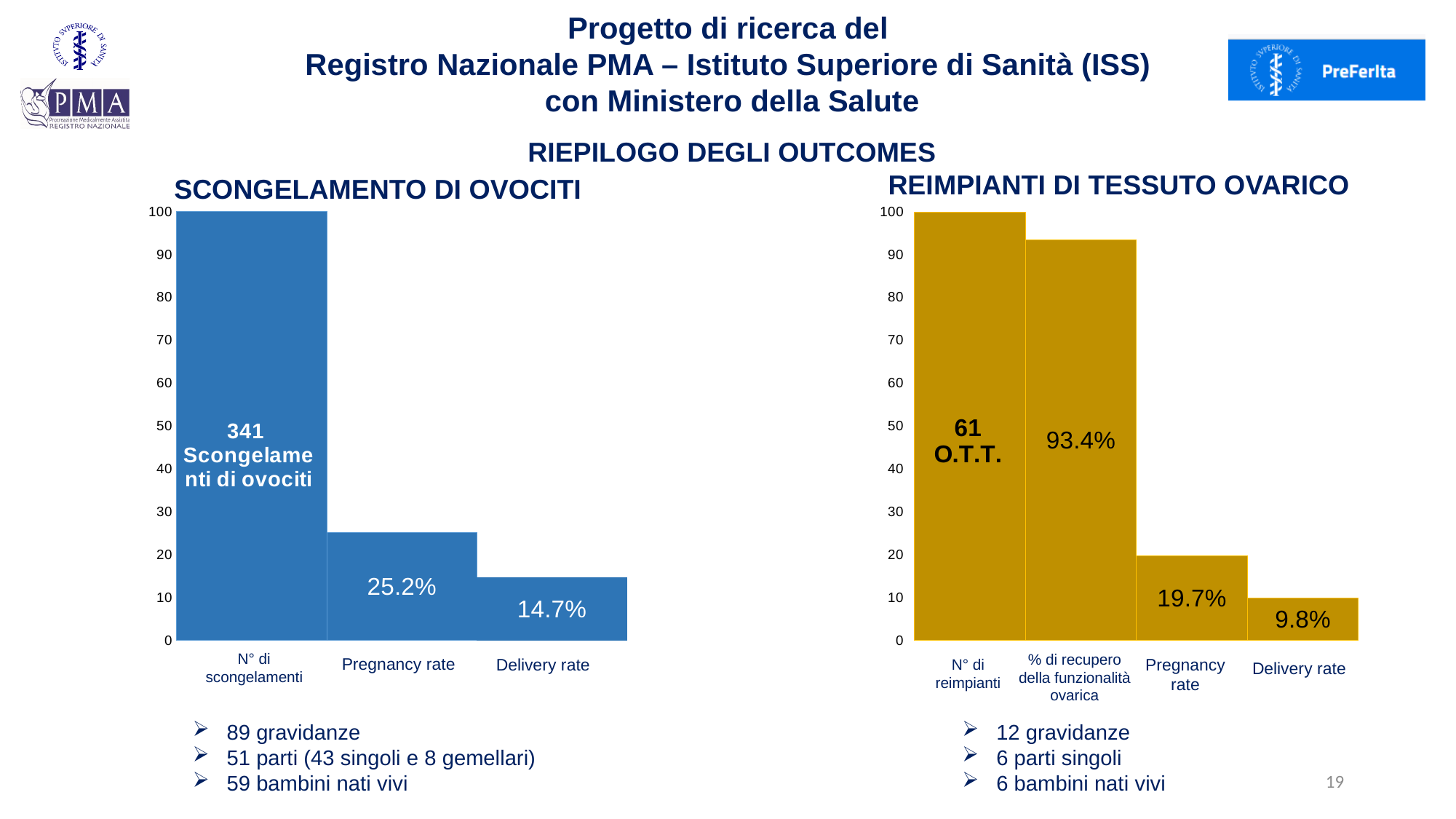
How many categories are shown on the x axis of the REIMPIANTI DI TESSUTO OVARICO chart? 4 In the REIMPIANTI DI TESSUTO OVARICO chart, how many percentage points higher is the Pregnancy rate than the Delivery rate? 9.9 In the SCONGELAMENTO DI OVOCITI chart, what is the Delivery rate? 14.7% In the REIMPIANTI DI TESSUTO OVARICO chart, what is the value for % di recupero della funzionalità ovarica? 93.4% What kind of chart is the SCONGELAMENTO DI OVOCITI chart? Bar chart In the REIMPIANTI DI TESSUTO OVARICO chart, which category has the lowest bar? Delivery rate Which chart shows the higher Pregnancy rate, SCONGELAMENTO DI OVOCITI or REIMPIANTI DI TESSUTO OVARICO? SCONGELAMENTO DI OVOCITI In the SCONGELAMENTO DI OVOCITI chart, what number is printed on the N° di scongelamenti bar? 341 In the REIMPIANTI DI TESSUTO OVARICO chart, what is the Delivery rate? 9.8% In the REIMPIANTI DI TESSUTO OVARICO chart, what is the Pregnancy rate? 19.7% In the SCONGELAMENTO DI OVOCITI chart, how many percentage points higher is the Pregnancy rate than the Delivery rate? 10.5 In the SCONGELAMENTO DI OVOCITI chart, what is the Pregnancy rate? 25.2%